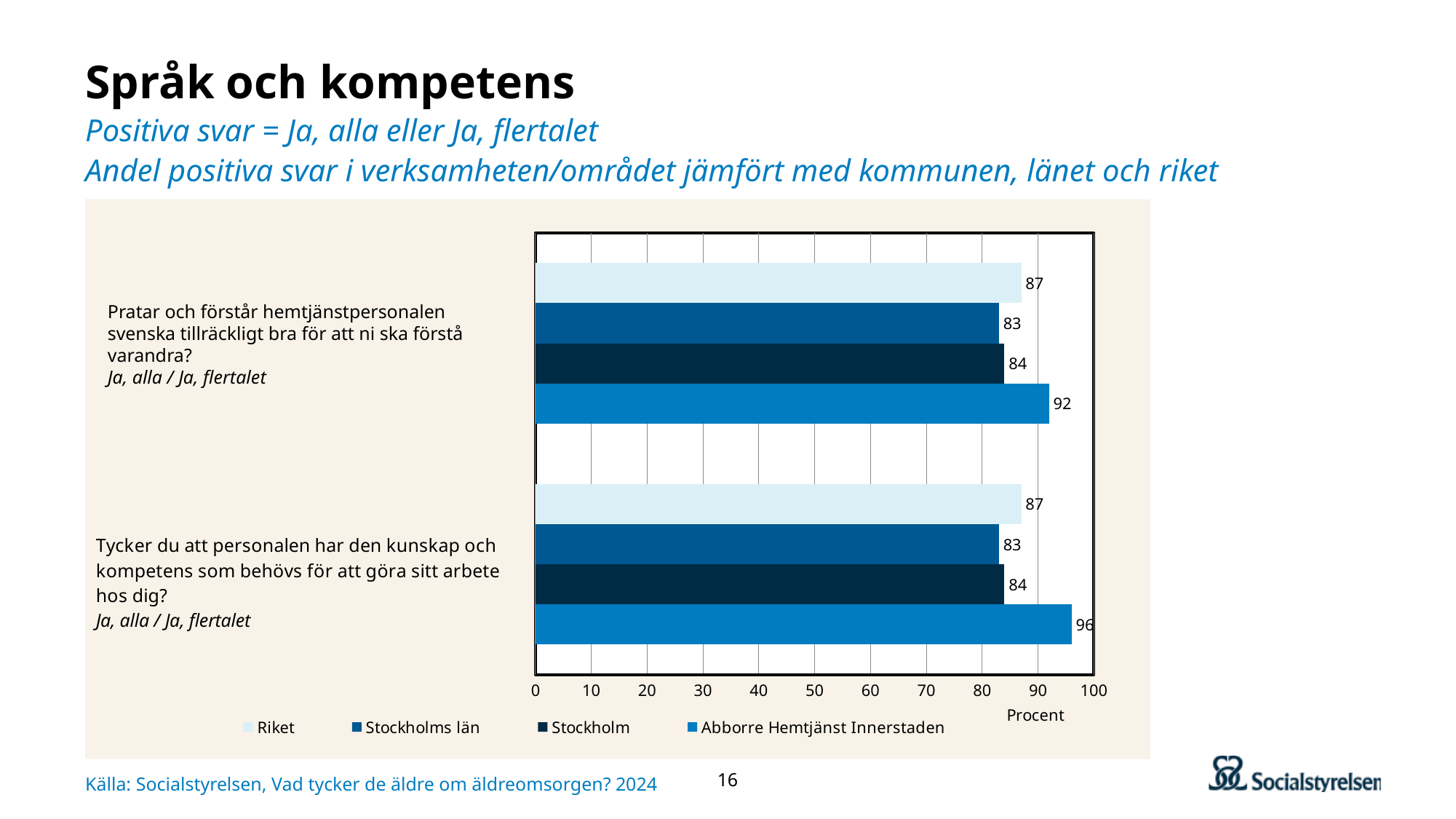
How many series does the legend list? 4 Which series has the highest value on the question about staff knowledge and competence? Abborre Hemtjänst Innerstaden What unit is shown on the x axis of the chart? Procent How many question categories are plotted on the chart? 2 What is the value for Riket on the question about whether staff have the knowledge and competence needed? 87 Which is larger on the question about staff speaking Swedish: the value for Stockholm or the value for Stockholms län? Stockholm What is the value for Abborre Hemtjänst Innerstaden on the question 'Tycker du att personalen har den kunskap och kompetens som behövs för att göra sitt arbete hos dig?' 96 What is the value for Stockholms län on the question about staff speaking and understanding Swedish well enough? 83 Which series has the lowest value on the question about staff speaking and understanding Swedish? Stockholms län What kind of chart is shown on the slide? bar chart What is the difference between Abborre Hemtjänst Innerstaden and Riket on the question about staff knowledge and competence? 9 What is the value for Abborre Hemtjänst Innerstaden on the question 'Pratar och förstår hemtjänstpersonalen svenska tillräckligt bra för att ni ska förstå varandra?' 92